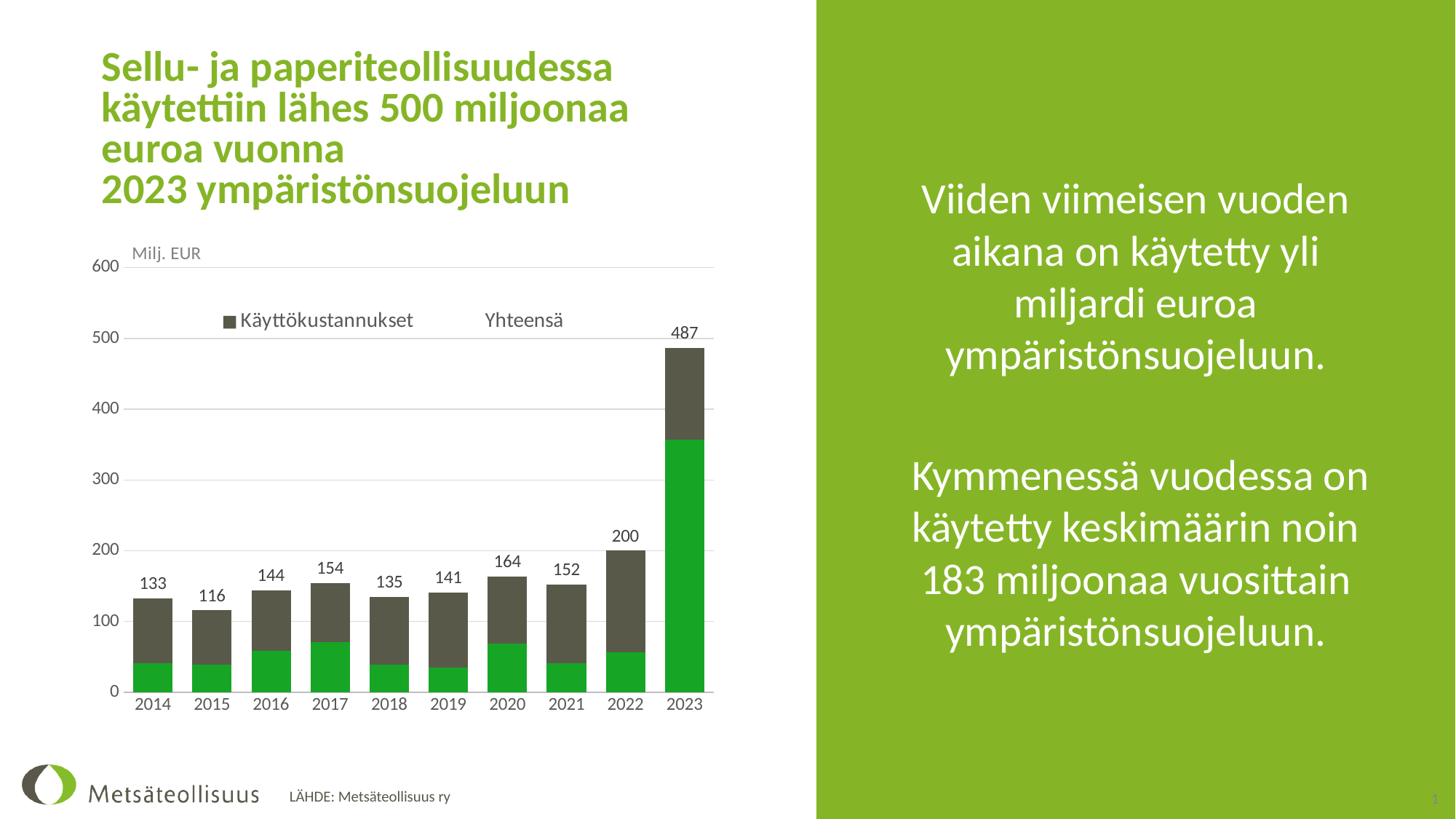
What is the total value shown for 2020? 164 What unit is given for the y axis of the chart? Milj. EUR Is the Käyttökustannukset (dark) segment for 2023 greater or less than 100? greater What is the difference between the totals for 2017 and 2018? 19 Which year has a larger total, 2019 or 2021? 2021 What is the total value shown for 2023? 487 How many years are shown on the x axis? 10 Which year has the highest total? 2023 What is the total value shown for 2014? 133 Which year has the lowest total? 2015 What kind of chart is shown on the slide? Stacked bar chart What is the difference between the totals for 2023 and 2022? 287